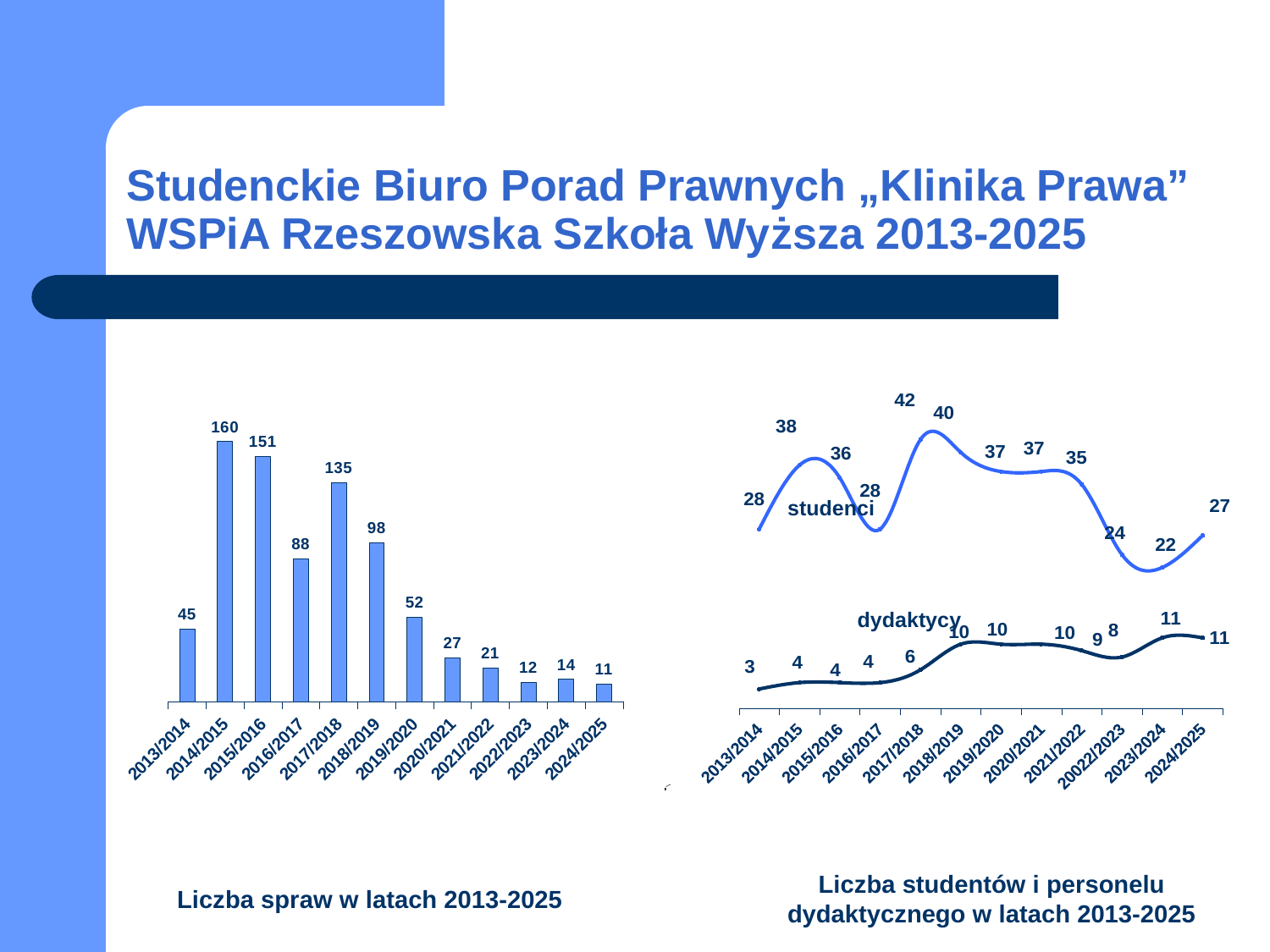
In the chart 'Liczba spraw w latach 2013-2025', what is the value for 2017/2018? 135 In the chart 'Liczba spraw w latach 2013-2025', what is the difference between the values for 2014/2015 and 2015/2016? 9 What kind of chart is 'Liczba spraw w latach 2013-2025'? bar chart In the chart 'Liczba spraw w latach 2013-2025', which year has the lowest value? 2024/2025 In the chart 'Liczba studentów i personelu dydaktycznego w latach 2013-2025', what is the value for dydaktycy in 2013/2014? 3 In the chart 'Liczba spraw w latach 2013-2025', how many years are shown on the x axis? 12 In the chart 'Liczba studentów i personelu dydaktycznego w latach 2013-2025', what is the value for studenci in 2017/2018? 42 In the chart 'Liczba studentów i personelu dydaktycznego w latach 2013-2025', what is the difference between studenci and dydaktycy in 2024/2025? 16 In the chart 'Liczba studentów i personelu dydaktycznego w latach 2013-2025', which is larger: studenci in 2014/2015 or studenci in 2018/2019? studenci in 2018/2019 What kind of chart is 'Liczba studentów i personelu dydaktycznego w latach 2013-2025'? line chart In the chart 'Liczba spraw w latach 2013-2025', which year has the highest value? 2014/2015 In the chart 'Liczba studentów i personelu dydaktycznego w latach 2013-2025', which year has the lowest value for studenci? 2023/2024